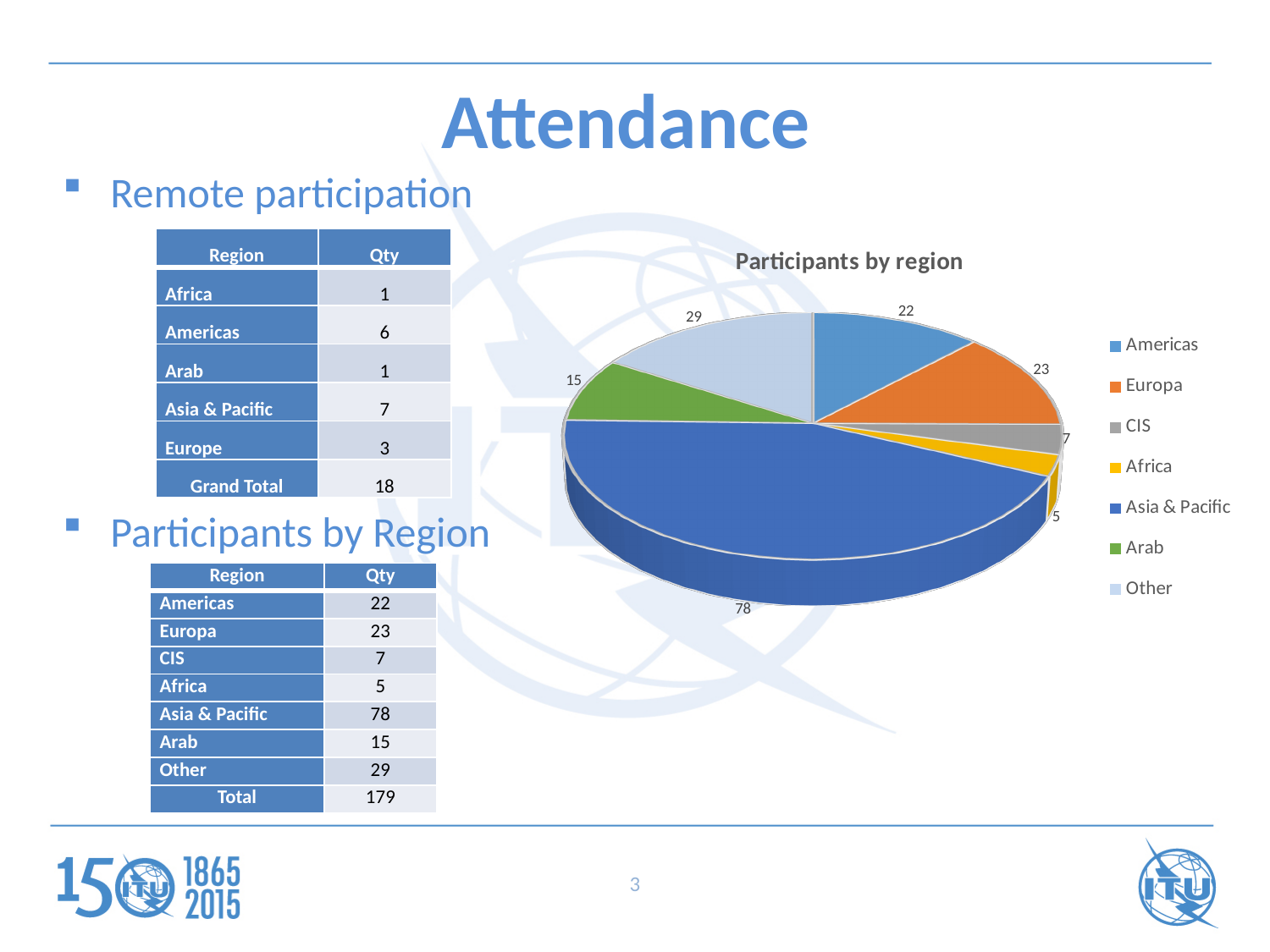
What is the value for Other in the pie chart? 29 What is the difference between the values for CIS and Africa in the pie chart? 2 Which region has the largest slice in the pie chart? Asia & Pacific What is the value for Asia & Pacific in the pie chart? 78 Which region has the smallest slice in the pie chart? Africa Which is larger in the pie chart, Europa or Americas? Europa How many slices does the pie chart have? 7 How many entries does the chart legend list? 7 What type of chart is shown on the slide? pie chart What is the difference between the values for Asia & Pacific and Other in the pie chart? 49 What is the value for Arab in the pie chart? 15 What is the title of the chart? Participants by region